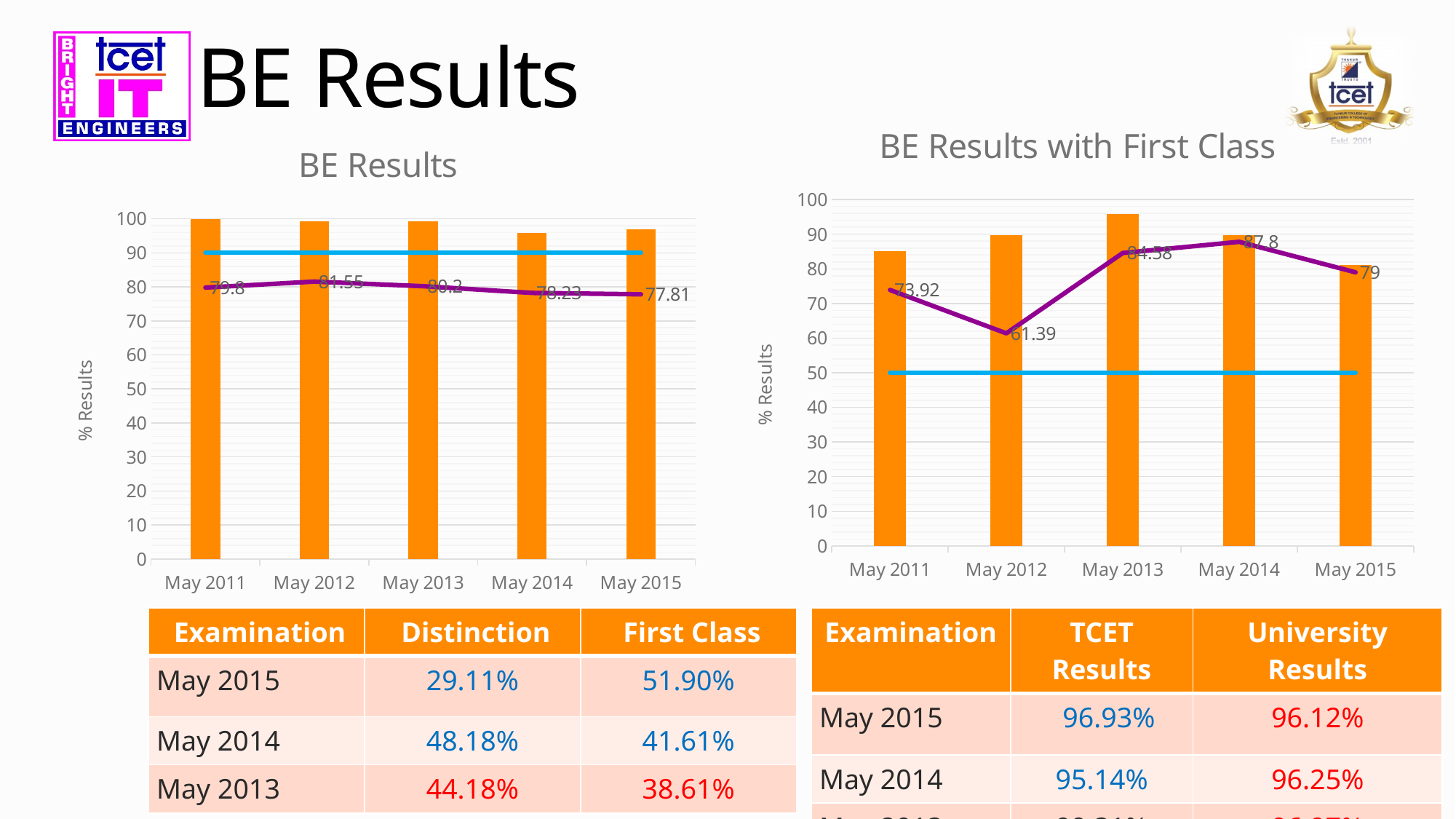
In the BE Results with First Class chart, what value does the line show for May 2012? 61.39 In the BE Results with First Class chart, which exam has the highest line value? May 2014 In the BE Results with First Class chart, what value does the line show for May 2015? 79 In the BE Results with First Class chart, which exam has the lowest line value? May 2012 How many exam periods are shown on the x axis of the BE Results chart? 5 In the BE Results with First Class chart, what is the difference between the line values for May 2014 and May 2012? 26.41 In the BE Results chart, what value does the line show for May 2012? 81.55 In the BE Results chart, which has the larger line value, May 2011 or May 2015? May 2011 What is the title of the y axis in the BE Results with First Class chart? % Results In the BE Results with First Class chart, is the bar for May 2013 greater or less than 90? greater In the BE Results chart, which exam has the lowest line value? May 2015 In the BE Results chart, what is the difference between the line values for May 2012 and May 2015? 3.74